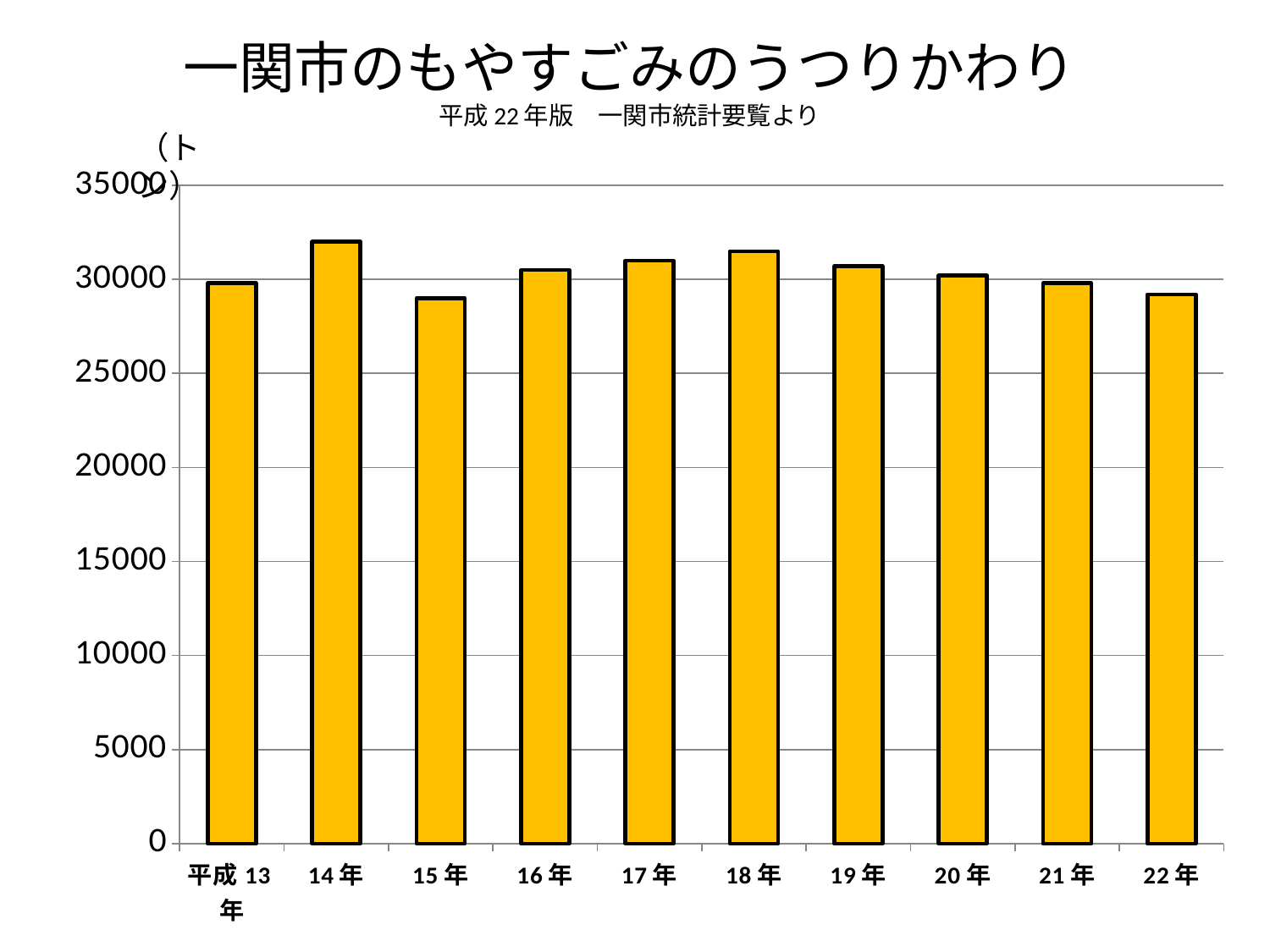
Which year has the highest amount of burnable garbage? 14年 Which is larger, the value for 18年 or the value for 22年? 18年 Is the value for 22年 greater or less than 30000? less From 18年 to 22年, do the values rise or fall? fall What kind of chart is shown on the slide? bar chart What unit is shown for the vertical axis? トン Which is larger, the value for 14年 or the value for 15年? 14年 Is the value for 14年 greater or less than 30000? greater How many years (bars) are plotted in the chart? 10 What is the title of the chart? 一関市のもやすごみのうつりかわり Is the value for 18年 greater or less than 30000? greater